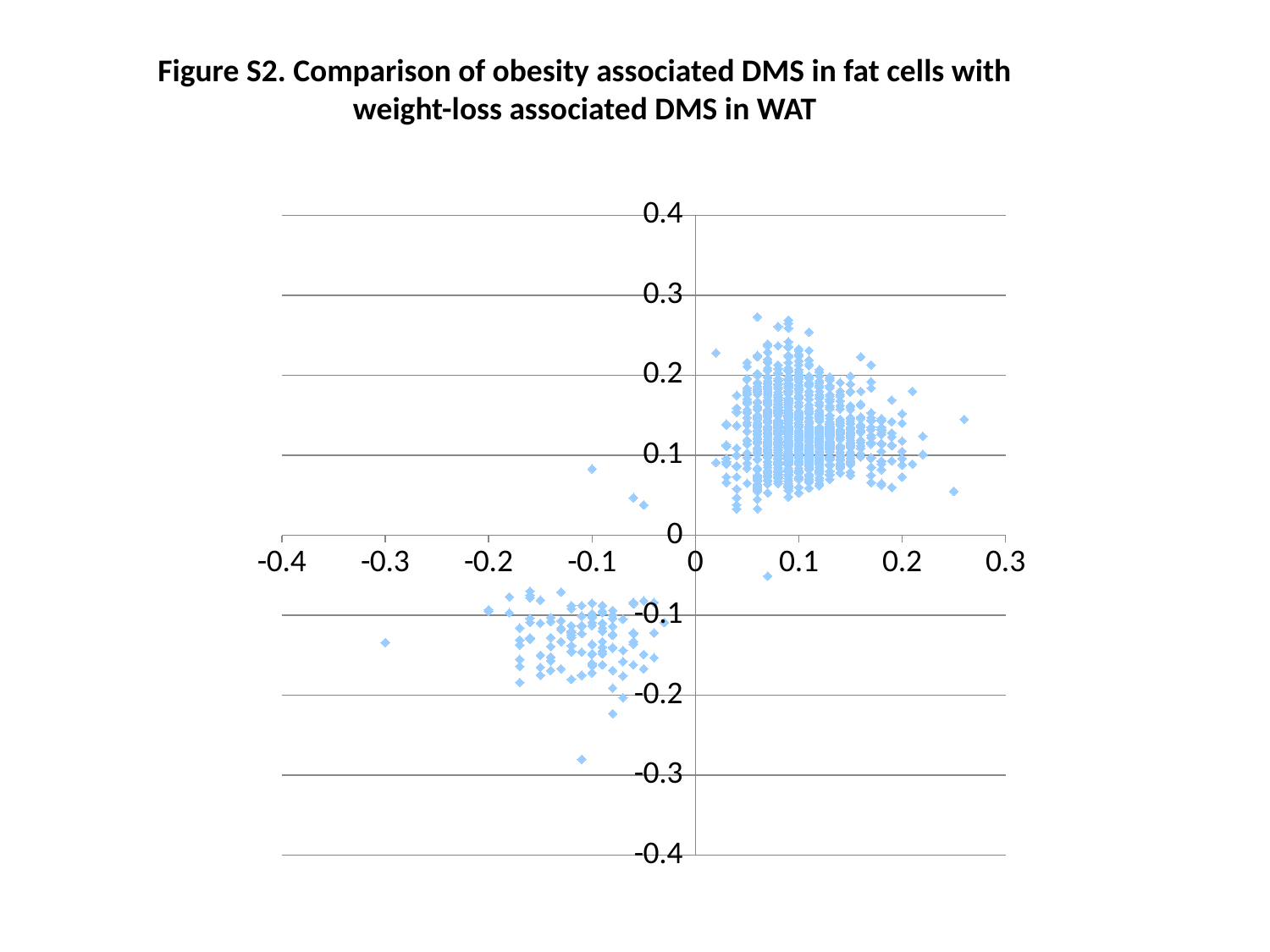
Do the plotted points generally rise or fall as the x value increases? rise What kind of chart is shown on the slide? scatter plot What is the maximum value shown on the y axis? 0.4 Is the x value of the rightmost plotted point greater or less than 0.2? greater Is the y value of the highest plotted point greater or less than 0.2? greater Is the y value of the lowest plotted point greater or less than -0.2? less Are the points with negative x values mostly above or below the y value of 0? below What is the title of the chart on the slide? Figure S2. Comparison of obesity associated DMS in fat cells with weight-loss associated DMS in WAT